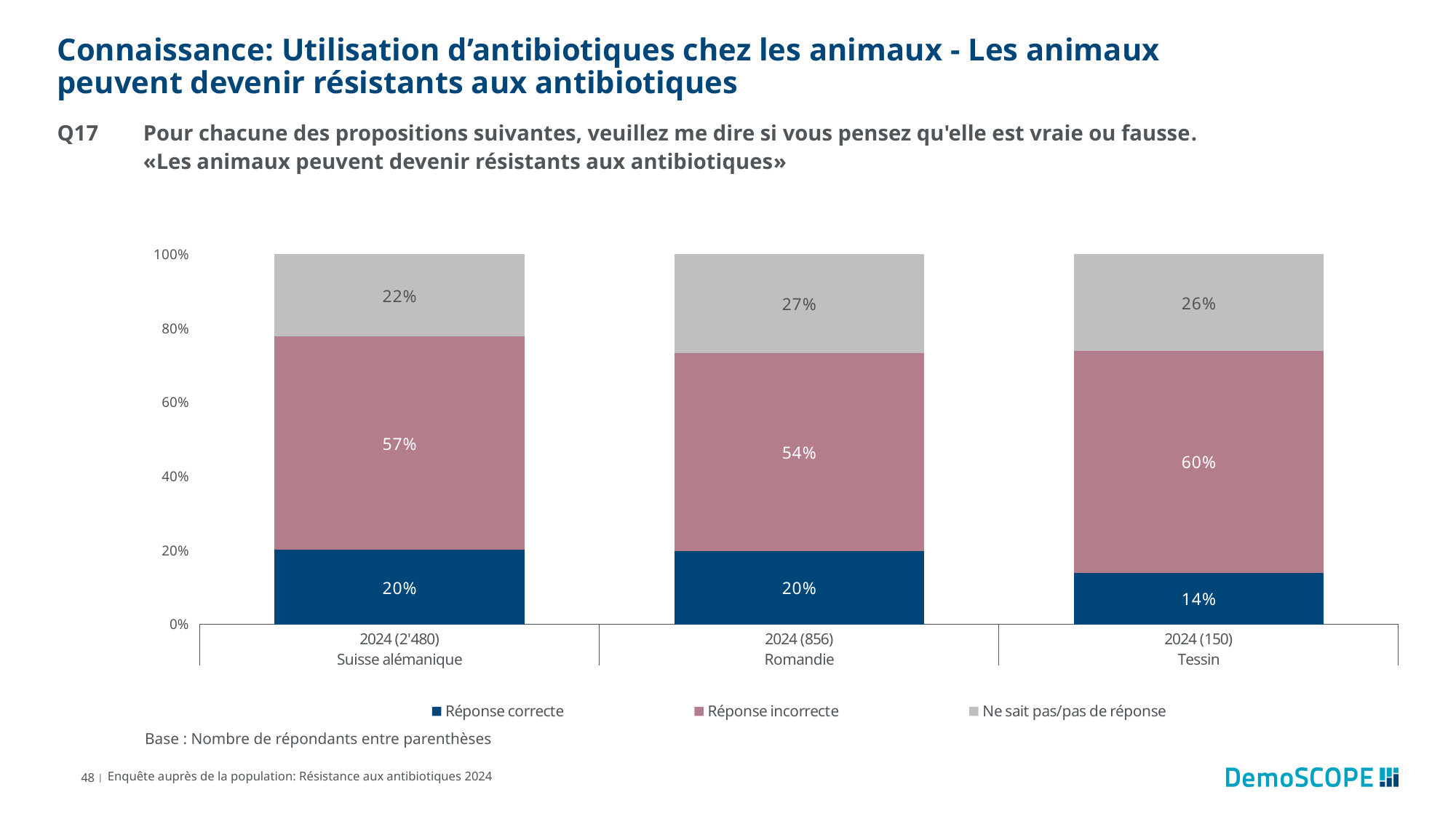
What is the number of respondents shown in parentheses for Romandie? 856 How many regions are shown on the x axis? 3 Which region has the lowest value for "Réponse correcte"? Tessin What kind of chart is shown on the slide? Stacked bar chart Which is larger: "Réponse incorrecte" in Suisse alémanique or in Romandie? Suisse alémanique What is the value for "Réponse correcte" in Tessin? 14% Which colour represents "Réponse correcte" in the legend? Dark blue How many series does the legend list? 3 What is the value for "Réponse incorrecte" in Romandie? 54% What is the difference between the "Ne sait pas/pas de réponse" values for Romandie and Suisse alémanique? 5% What is the value for "Ne sait pas/pas de réponse" in Suisse alémanique? 22% Which region has the highest value for "Réponse incorrecte"? Tessin